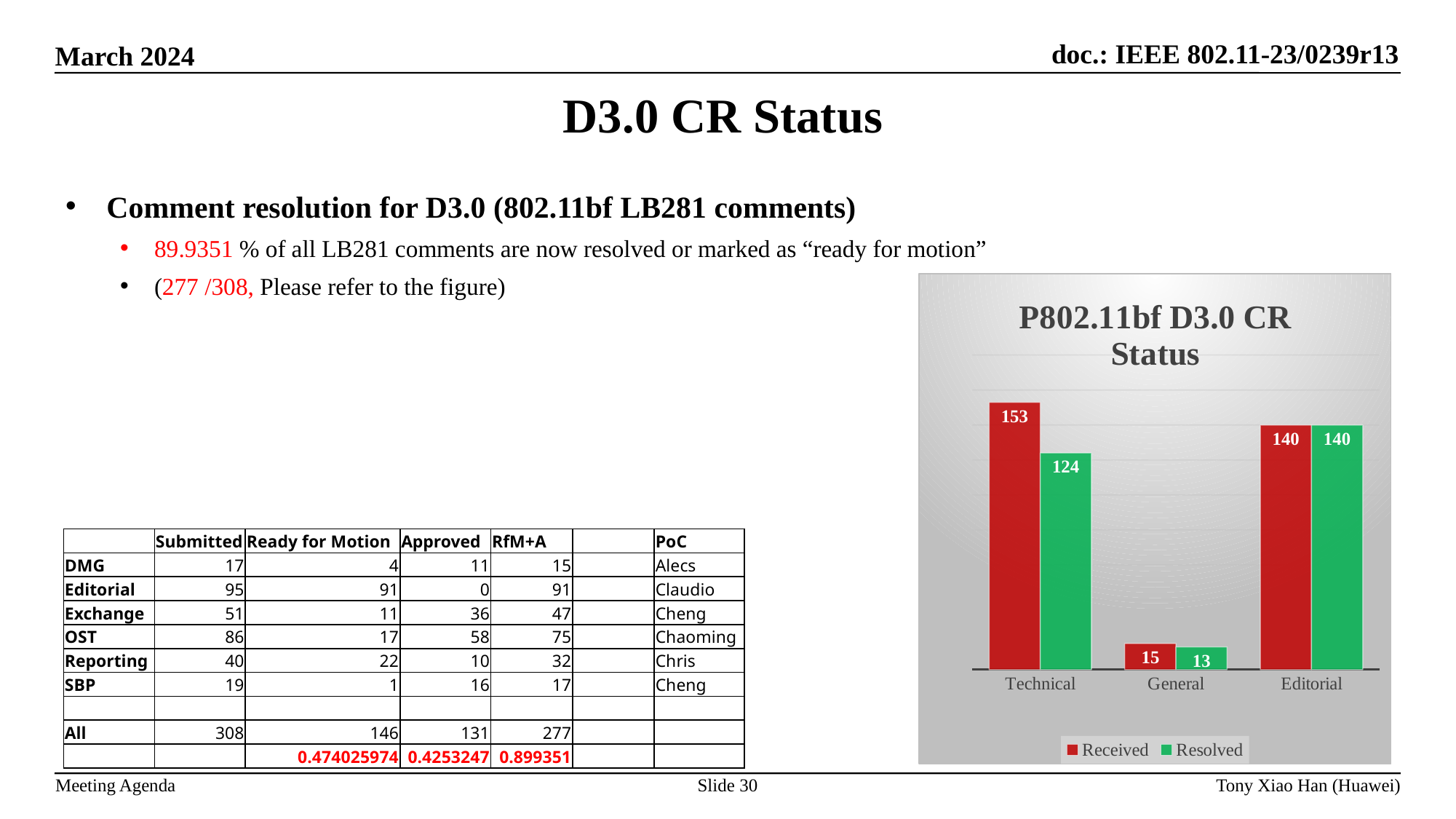
What is the Received value for Technical in the P802.11bf D3.0 CR Status chart? 153 What is the difference between Received and Resolved for General in the P802.11bf D3.0 CR Status chart? 2 What is the Resolved value for General in the P802.11bf D3.0 CR Status chart? 13 Which category has the highest Received value in the P802.11bf D3.0 CR Status chart? Technical What kind of chart is the P802.11bf D3.0 CR Status chart? Bar chart How many categories are shown on the x axis of the P802.11bf D3.0 CR Status chart? 3 What is the Resolved value for Editorial in the P802.11bf D3.0 CR Status chart? 140 What is the difference between Received and Resolved for Technical in the P802.11bf D3.0 CR Status chart? 29 Which category has the lowest Resolved value in the P802.11bf D3.0 CR Status chart? General How many series does the legend of the P802.11bf D3.0 CR Status chart list? 2 What colour are the Resolved bars in the P802.11bf D3.0 CR Status chart? Green Is the Received value for Technical or the Received value for Editorial larger in the P802.11bf D3.0 CR Status chart? Technical